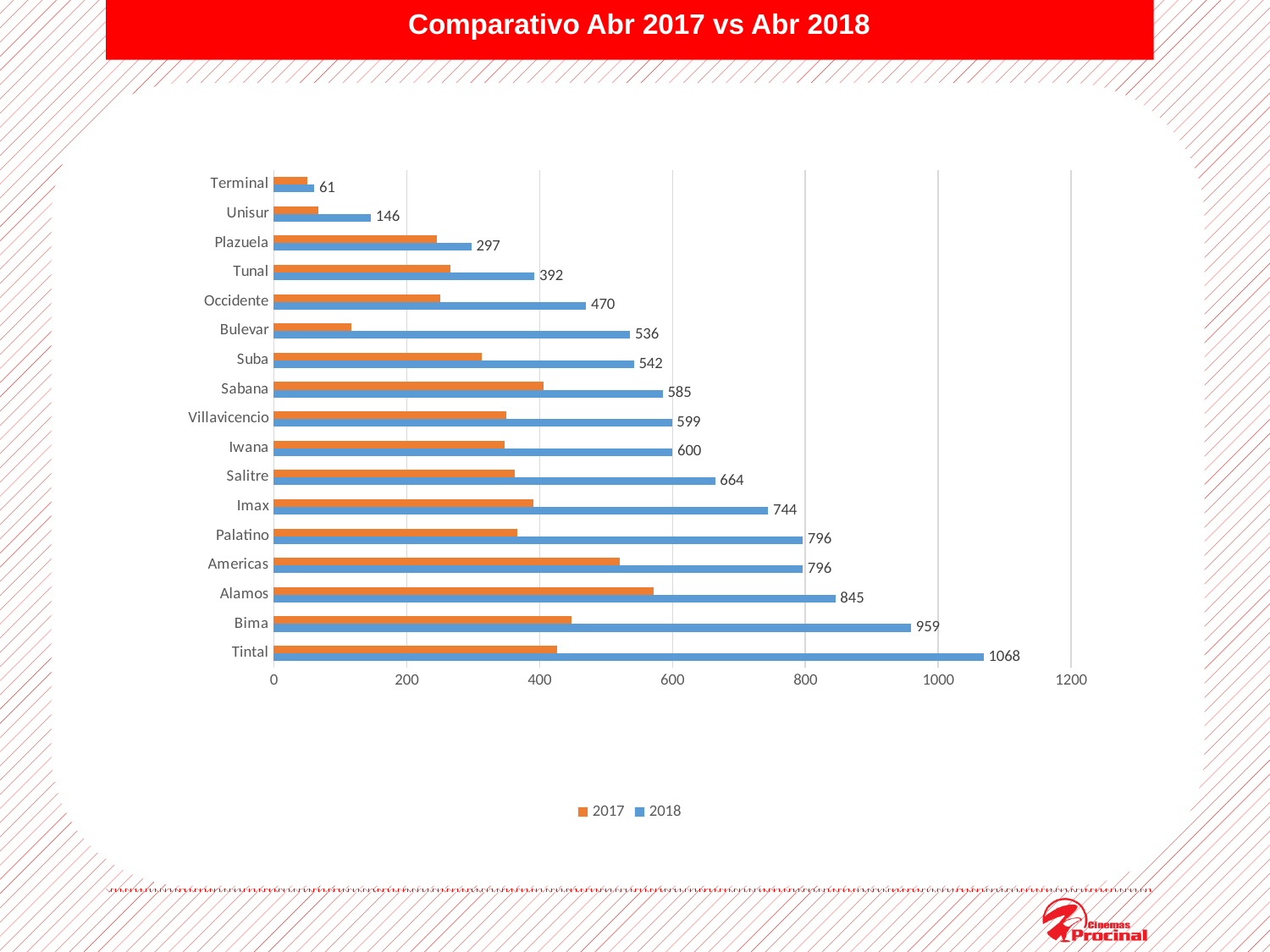
What is the 2018 value for Tintal? 1068 What is the 2018 value for Salitre? 664 What is the 2018 value for Terminal? 61 What type of chart is shown on the slide? Bar chart Which category has the highest 2018 value? Tintal How many series does the legend list? 2 Is the 2017 value for Alamos greater or less than 400? greater Which has the larger 2018 value, Imax or Salitre? Imax Is the 2017 value for Bulevar greater or less than 200? less What is the difference between the 2018 values for Tintal and Bima? 109 How many categories are shown on the chart? 17 Which category has the lowest 2018 value? Terminal